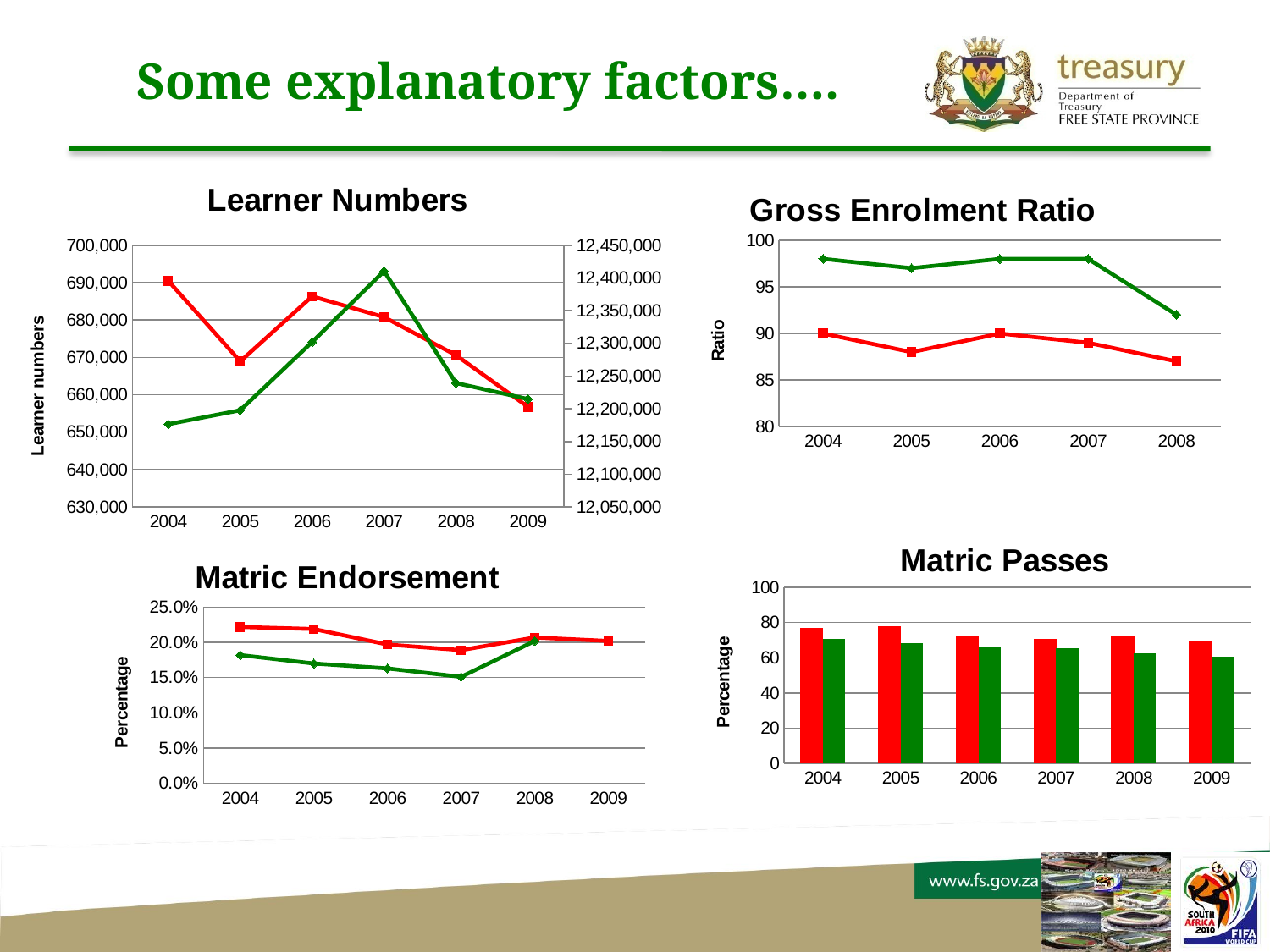
In the Matric Endorsement chart, in which year is the green line at its lowest point? 2007 How many years are shown on the x axis of the Learner Numbers chart? 6 In the Gross Enrolment Ratio chart, in which year is the green line at its lowest point? 2008 In the Gross Enrolment Ratio chart, is the red line's value for 2005 greater or less than 90? less In the Matric Endorsement chart, does the green line rise or fall from 2004 to 2007? fall What kind of chart is the Matric Passes chart? bar chart In the Learner Numbers chart, in which year does the green line reach its highest point? 2007 In the Matric Passes chart, which bar is taller for 2004, the red bar or the green bar? red bar How many years are shown on the x axis of the Gross Enrolment Ratio chart? 5 In the Learner Numbers chart, in which year is the red line at its highest point? 2004 In the Gross Enrolment Ratio chart, is the green line's value for 2008 greater or less than 90? greater What kind of chart is the Learner Numbers chart? line chart